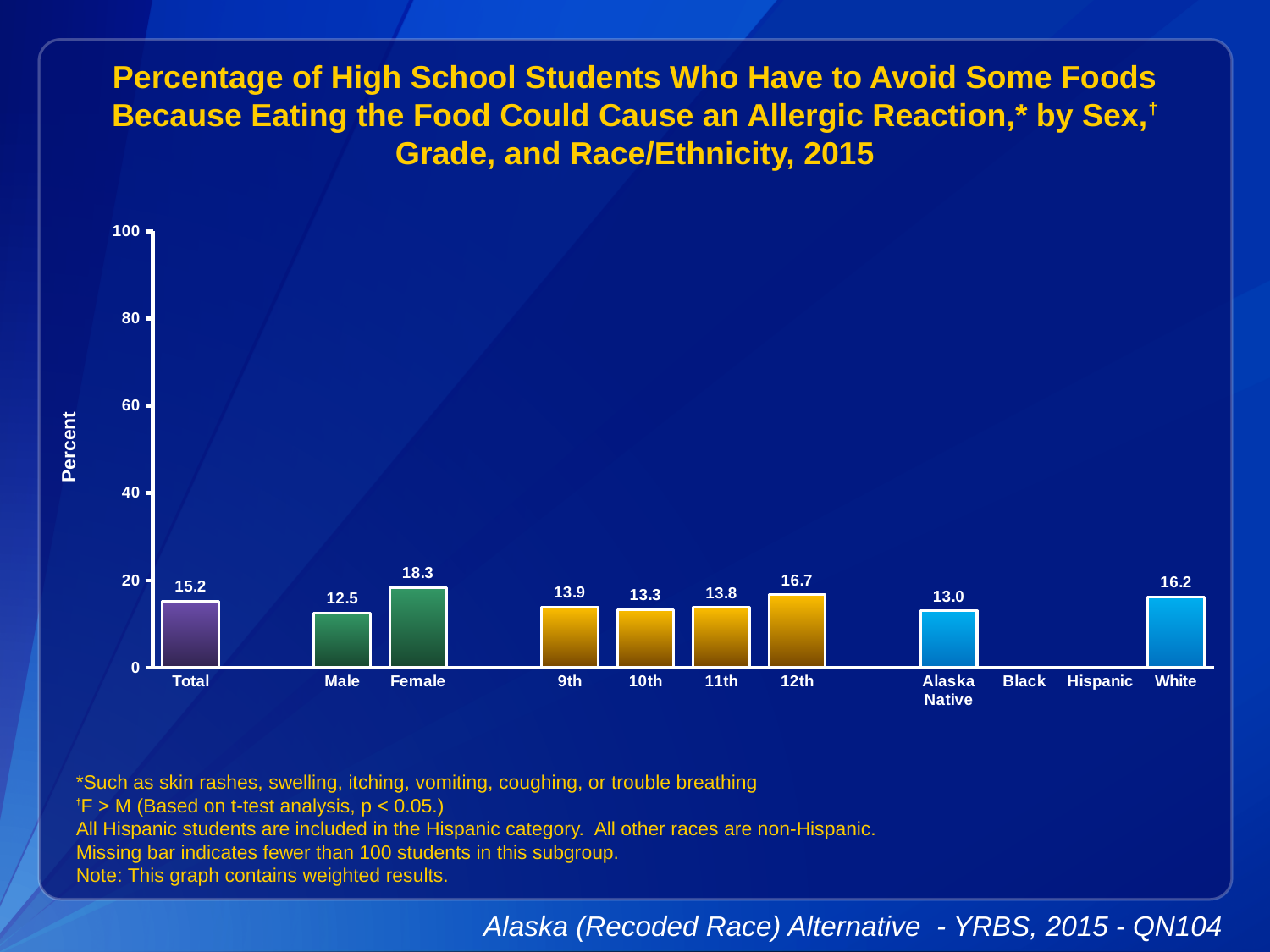
Which category has the lowest value among the bars shown? Male Which categories have no bar shown? Black and Hispanic Which is larger, the value for White or the value for 11th grade? White Which category has the highest value? Female What is the value for Total? 15.2 What is the difference between the Female and Male values? 5.8 Is the value for 9th grade greater or less than 20? less What is the value for Female? 18.3 What is the value for Alaska Native? 13.0 What is the value for 12th grade? 16.7 How many categories have a bar plotted? 9 What kind of chart is this? bar chart